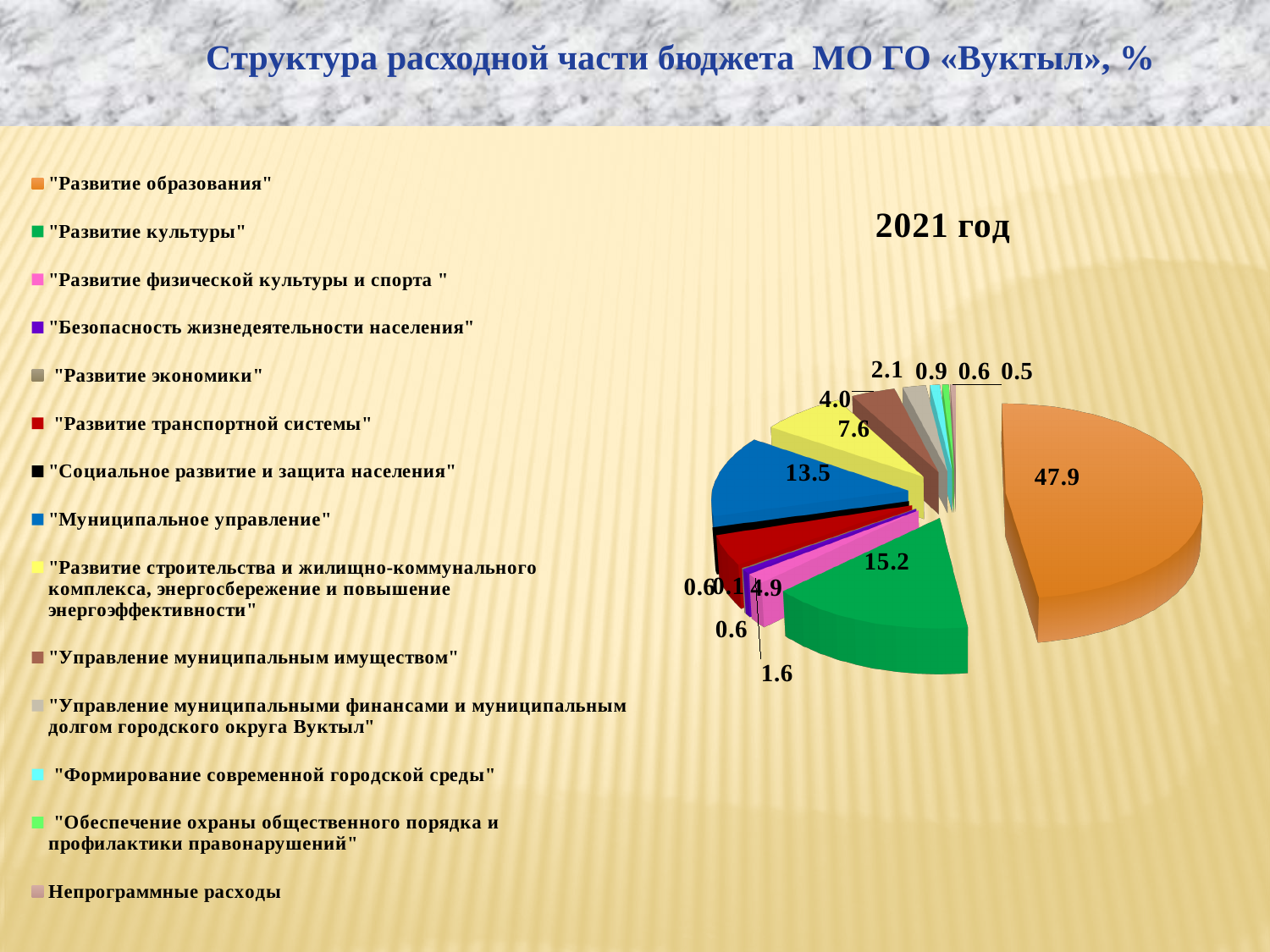
How many entries does the legend of the pie chart list? 14 What is the difference between the values for "Развитие образования" and "Развитие культуры"? 32.7 What is the value for "Развитие физической культуры и спорта"? 1.6 What is the value for "Развитие культуры"? 15.2 What is the value for "Развитие строительства и жилищно-коммунального комплекса, энергосбережение и повышение энергоэффективности"? 7.6 What is the value for "Развитие образования"? 47.9 What is the value for "Управление муниципальным имуществом"? 4.0 What is the value for "Муниципальное управление"? 13.5 Which category has the largest slice of the pie chart? "Развитие образования" Which is larger, the value for "Муниципальное управление" or the value for "Развитие культуры"? "Развитие культуры" What is the title shown above the pie chart? 2021 год What kind of chart is shown on the slide? pie chart